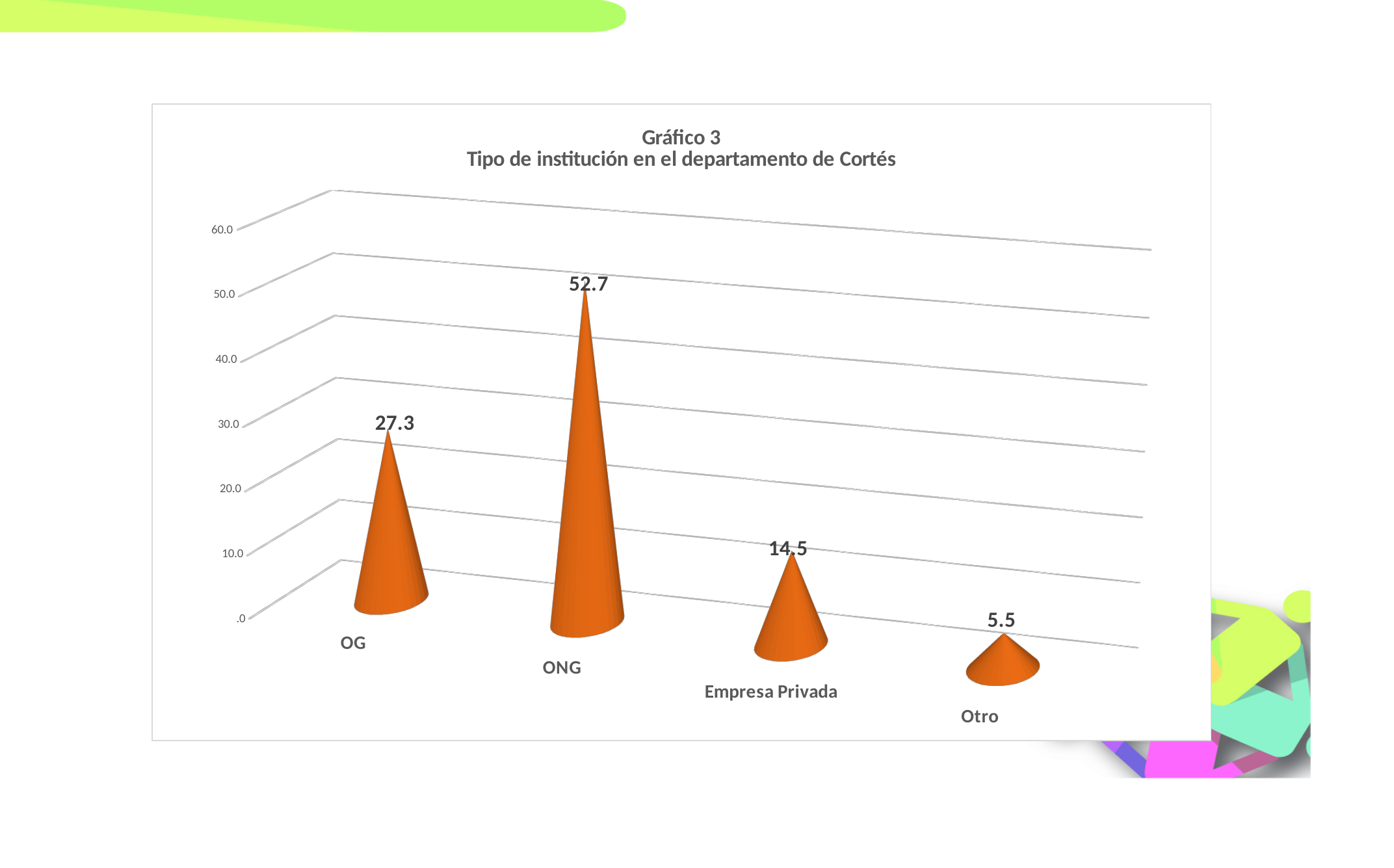
What is the title of the chart? Gráfico 3 Tipo de institución en el departamento de Cortés What is the difference between the values for ONG and OG? 25.4 What is the value for Otro? 5.5 Which category has the highest value? ONG What is the value for OG? 27.3 Which category has the lowest value? Otro What is the value for Empresa Privada? 14.5 What is the difference between the values for Empresa Privada and Otro? 9.0 What kind of chart is this? Bar chart What is the value for ONG? 52.7 How many categories are shown on the x axis? 4 Which is larger, the value for OG or the value for Empresa Privada? OG